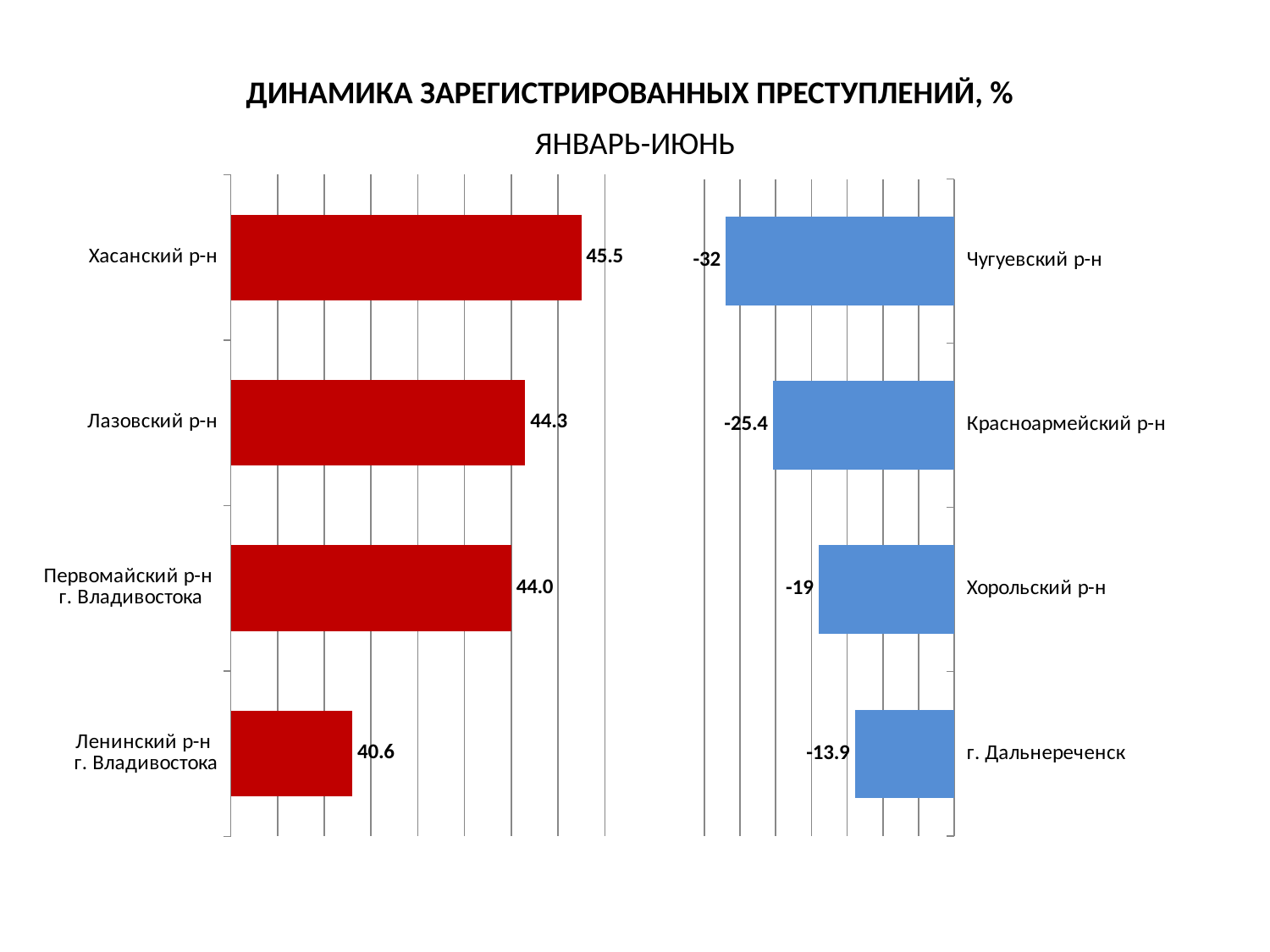
On the left chart with red bars, what is the difference between the values for Хасанский р-н and Ленинский р-н г. Владивостока? 4.9 What type of chart is used on this slide? Bar chart On the right chart with blue bars, what is the value for г. Дальнереченск? -13.9 On the left chart with red bars, which category has the lowest value? Ленинский р-н г. Владивостока On the right chart with blue bars, what is the difference between the values for г. Дальнереченск and Чугуевский р-н? 18.1 On the left chart with red bars, what is the value for Хасанский р-н? 45.5 How many categories are shown on the right chart with blue bars? 4 On the left chart with red bars, which is larger: the value for Лазовский р-н or Первомайский р-н г. Владивостока? Лазовский р-н On the right chart with blue bars, which category has the lowest value? Чугуевский р-н On the right chart with blue bars, what is the value for Красноармейский р-н? -25.4 On the left chart with red bars, what is the value for Ленинский р-н г. Владивостока? 40.6 On the left chart with red bars, which category has the highest value? Хасанский р-н